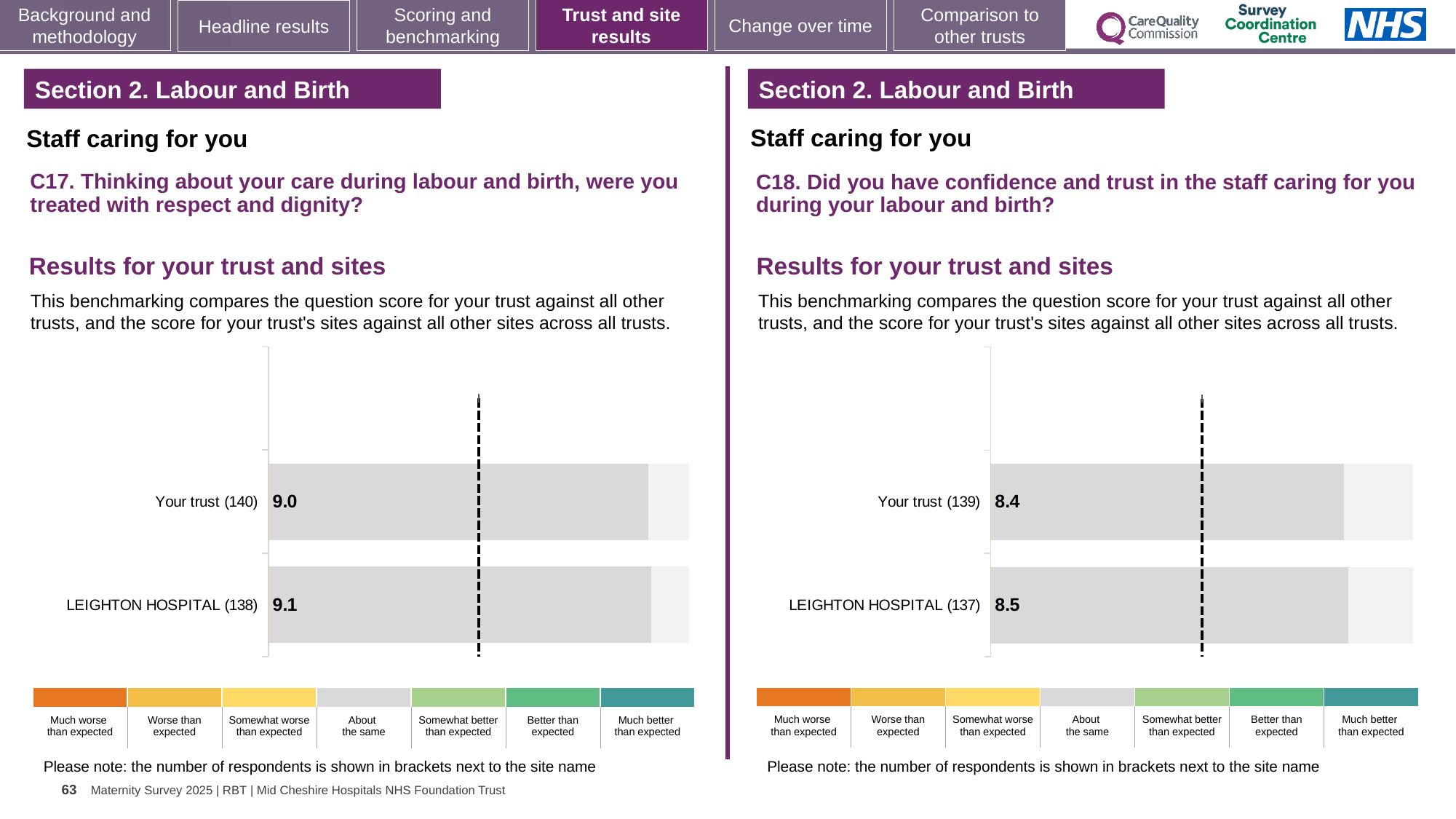
In the C17 chart on the left, what is the difference between the LEIGHTON HOSPITAL score and the Your trust score? 0.1 In the C18 chart on the right, what is the score for Your trust (139)? 8.4 In the C18 chart on the right, how many respondents are shown in brackets for LEIGHTON HOSPITAL? 137 In the C18 chart on the right, which has the lower score, Your trust or LEIGHTON HOSPITAL? Your trust How many categories does the colour key below the C17 chart on the left list? 7 How many bars are shown in the C17 chart on the left? 2 In the C18 chart on the right, what is the score for LEIGHTON HOSPITAL (137)? 8.5 In the C18 chart on the right, what is the difference between the LEIGHTON HOSPITAL score and the Your trust score? 0.1 In the C17 chart on the left, what is the score for Your trust (140)? 9.0 In the C17 chart on the left, what is the score for LEIGHTON HOSPITAL (138)? 9.1 In the C17 chart on the left, which has the higher score, Your trust or LEIGHTON HOSPITAL? LEIGHTON HOSPITAL What type of chart is used in the C18 chart on the right? Bar chart